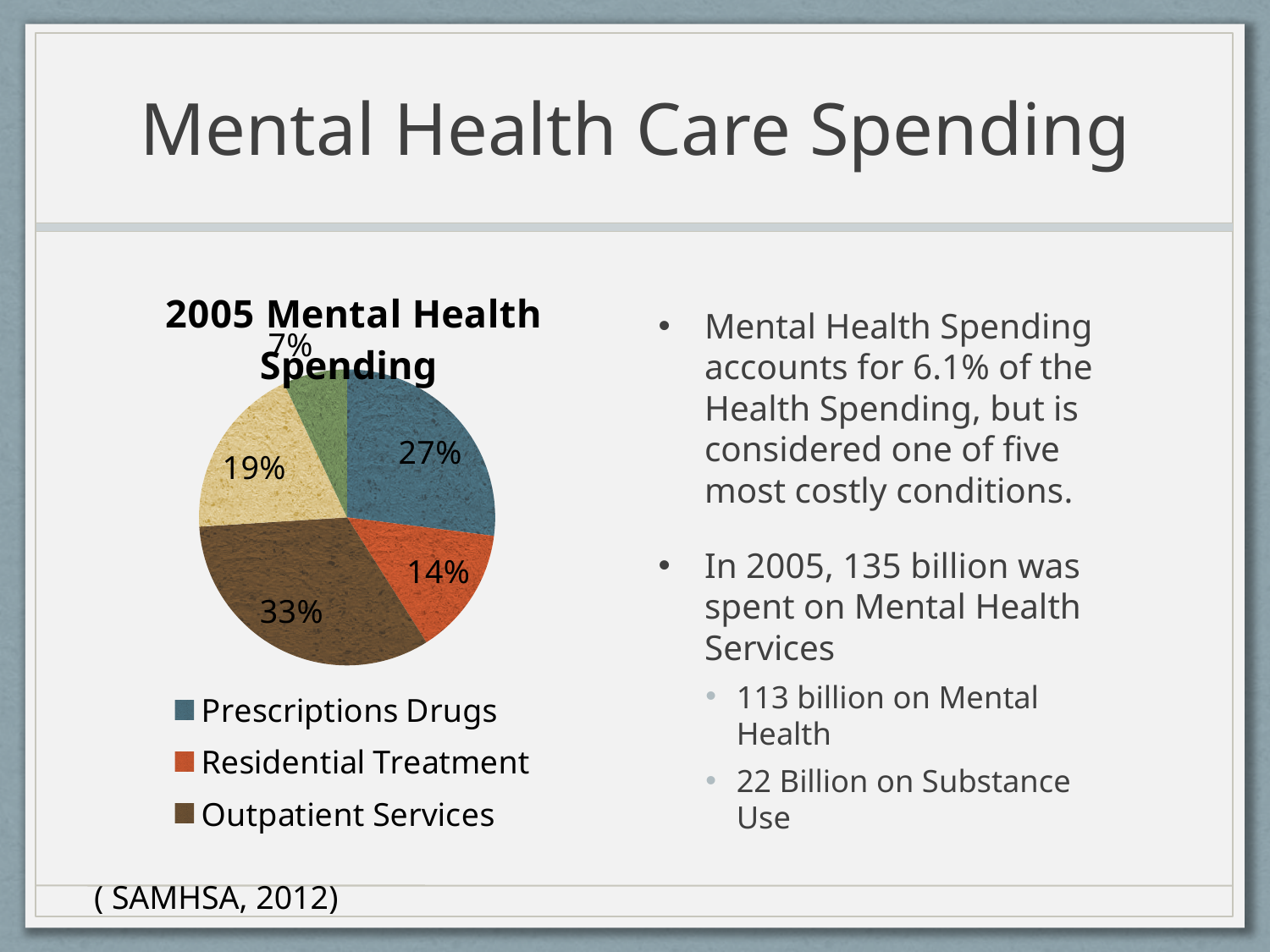
What colour is the Outpatient Services slice in the legend? brown What is the difference in percentage points between Outpatient Services and Residential Treatment? 19 What percentage of 2005 mental health spending went to Outpatient Services? 33% Which legend category has the largest share of the pie? Outpatient Services What type of chart is shown on the slide? pie chart Which is larger, the share for Prescriptions Drugs or the share for Residential Treatment? Prescriptions Drugs What is the title of the chart? 2005 Mental Health Spending What percentage of 2005 mental health spending went to Prescriptions Drugs? 27% What is the smallest percentage shown on the pie chart? 7% How many slices does the pie chart have? 5 What percentage of 2005 mental health spending went to Residential Treatment? 14% How many entries does the legend list? 3